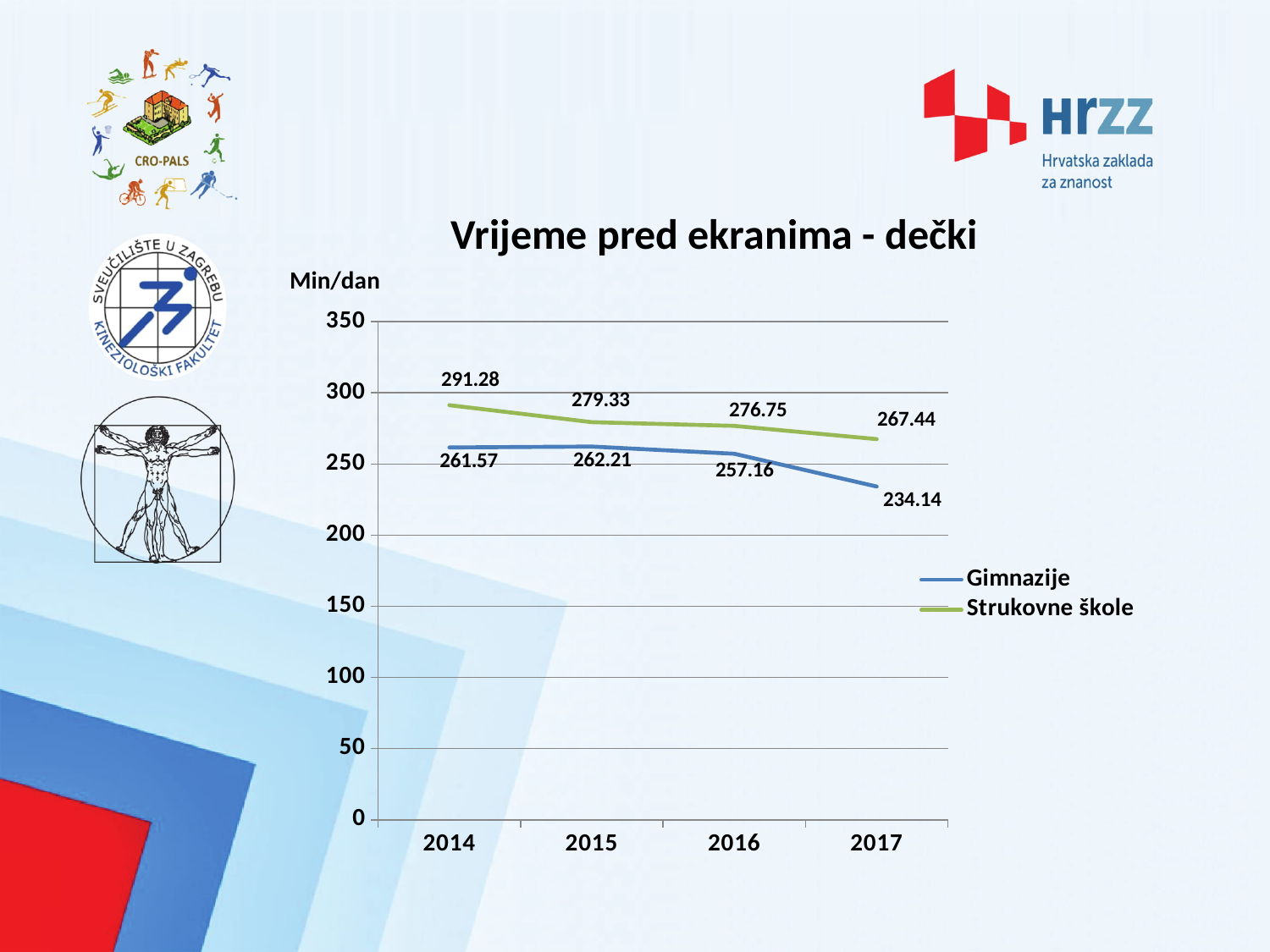
Do the Gimnazije values rise or fall from 2015 to 2017? Fall What is the value for Strukovne škole in 2015? 279.33 What is the value for Gimnazije in 2017? 234.14 What is the value for Strukovne škole in 2017? 267.44 How many years are shown on the x axis? 4 What kind of chart is shown on the slide? Line chart How many series does the legend list? 2 In which year is the Strukovne škole value highest? 2014 What is the value for Gimnazije in 2014? 261.57 Which series has the larger value in 2017, Gimnazije or Strukovne škole? Strukovne škole In which year is the Gimnazije value lowest? 2017 What is the difference between Strukovne škole and Gimnazije in 2016? 19.59